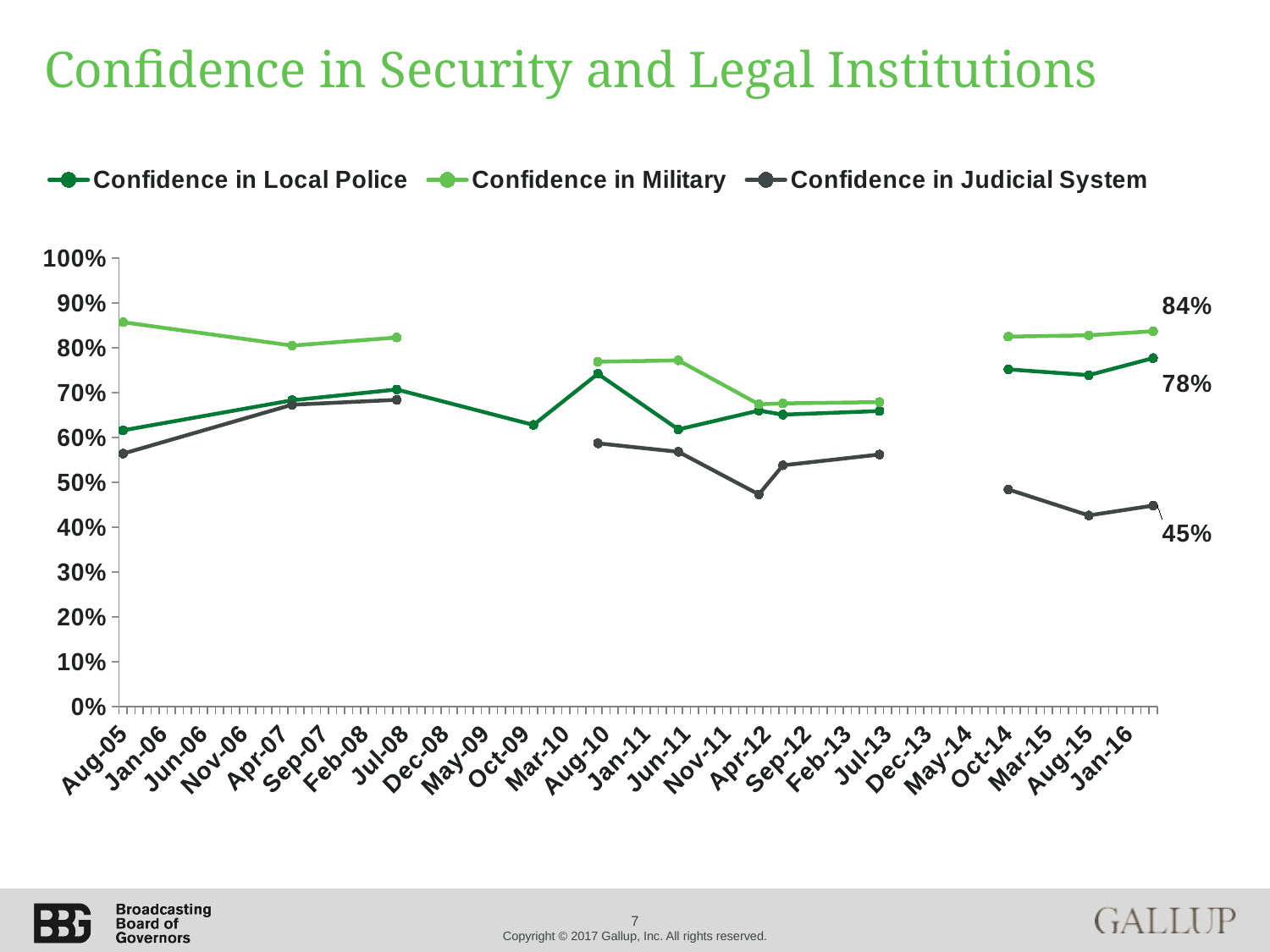
Is the value for Confidence in Military at Aug-05 greater or less than 80%? greater How many series does the legend list? 3 What kind of chart is shown on the slide? Line chart Which series has the lowest value at Jan-16? Confidence in Judicial System What is the value for Confidence in Judicial System at Jan-16? 45% What is the value for Confidence in Local Police at Jan-16? 78% Is the value for Confidence in Judicial System at Aug-15 greater or less than 50%? less What is the title of the chart? Confidence in Security and Legal Institutions What is the difference between Confidence in Military and Confidence in Judicial System at Jan-16? 39 percentage points Which series has the highest value at Jan-16? Confidence in Military What is the difference between Confidence in Military and Confidence in Local Police at Jan-16? 6 percentage points What is the value for Confidence in Military at Jan-16? 84%